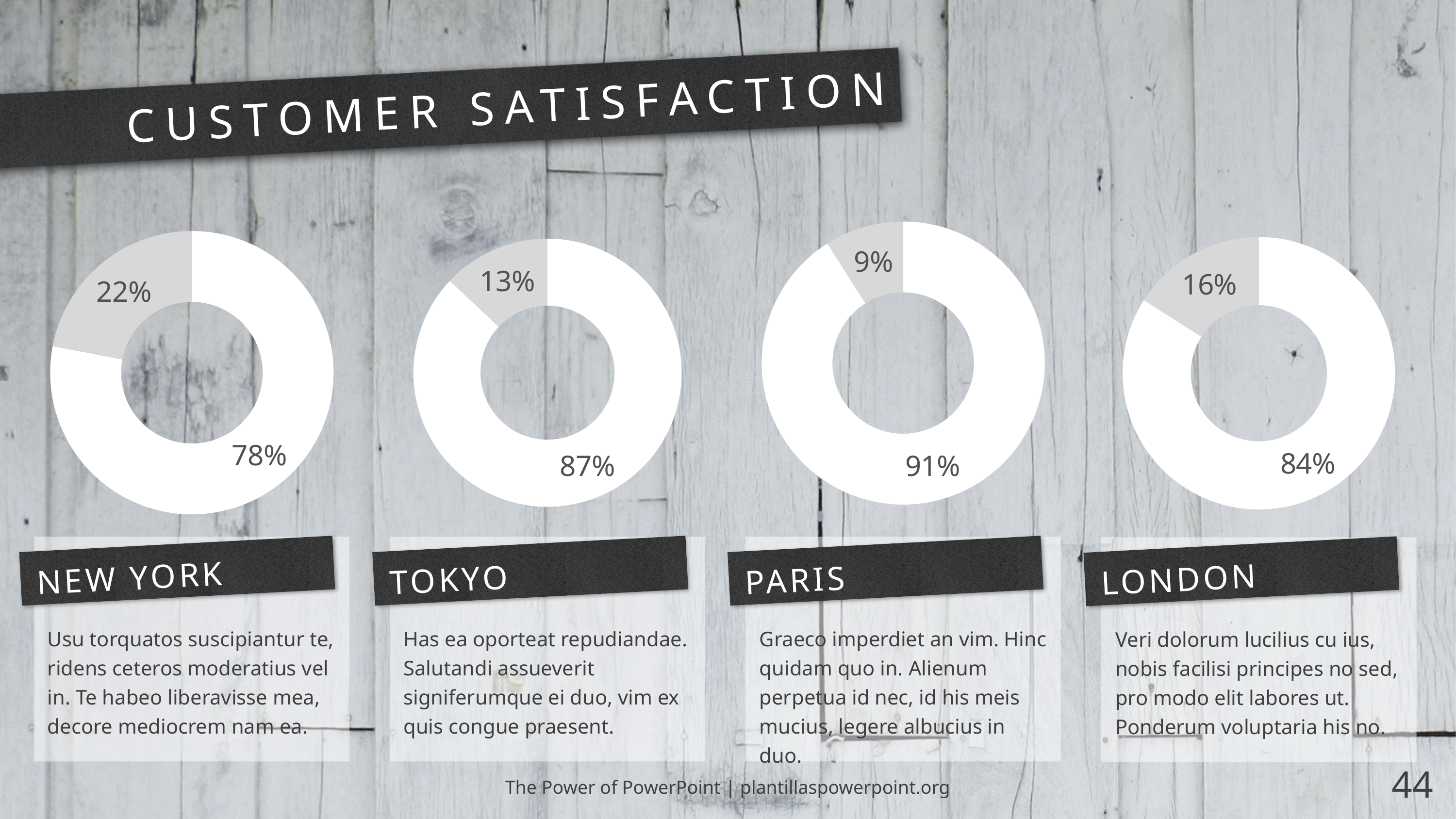
In the Paris chart, what is the value of the larger (white) slice? 91% In the Tokyo chart, what is the value of the smaller (grey) slice? 13% Which city's chart shows the highest white-slice value? Paris Which city's chart shows the lowest white-slice value? New York In the London chart, what is the value of the smaller (grey) slice? 16% What is the title of the slide containing the charts? Customer Satisfaction What kind of chart is used for each city on this slide? Doughnut chart In the New York chart, what is the value of the larger (white) slice? 78% How many charts are shown on the slide? 4 How many slices does the New York chart have? 2 What is the difference between the white-slice values in the Paris chart and the New York chart? 13% Which is larger: the white-slice value in the Tokyo chart or in the London chart? Tokyo